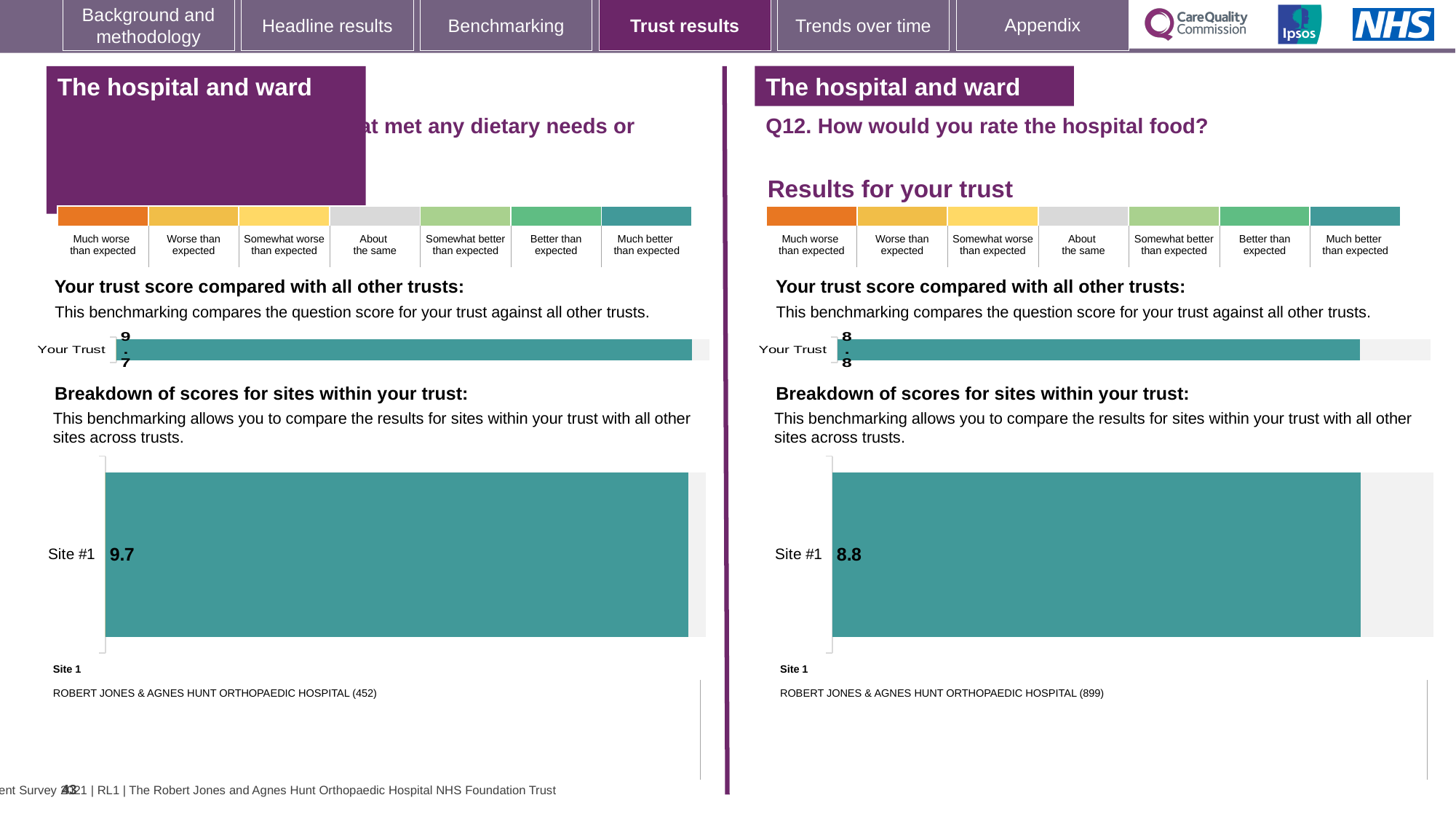
On the right-hand panel (Q12), what is the score shown for Site #1 in the breakdown of scores for sites within your trust? 8.8 Which is larger: the Site #1 score on the left-hand panel or the Site #1 score on the right-hand panel (Q12)? Left-hand panel (9.7) On the left-hand panel, what is the score shown for Your Trust in the 'Your trust score compared with all other trusts' chart? 9.7 On the right-hand panel (Q12. How would you rate the hospital food?), what is the score shown for Your Trust? 8.8 What is the difference between the Your Trust score on the left-hand panel (9.7) and the Your Trust score on the right-hand panel (8.8)? 0.9 What colour are the Your Trust and Site #1 bars on both panels of the slide? Teal What type of chart is used to show the Site #1 score on the right-hand panel (Q12)? Bar chart How many sites are shown in the breakdown of scores for sites within your trust on the right-hand panel (Q12)? 1 On the left-hand panel, what is the score shown for Site #1 in the breakdown of scores for sites within your trust? 9.7 On the right-hand panel (Q12), which site name is listed as Site 1 below the chart? ROBERT JONES & AGNES HUNT ORTHOPAEDIC HOSPITAL (899) How many sites are shown in the breakdown of scores for sites within your trust on the left-hand panel? 1